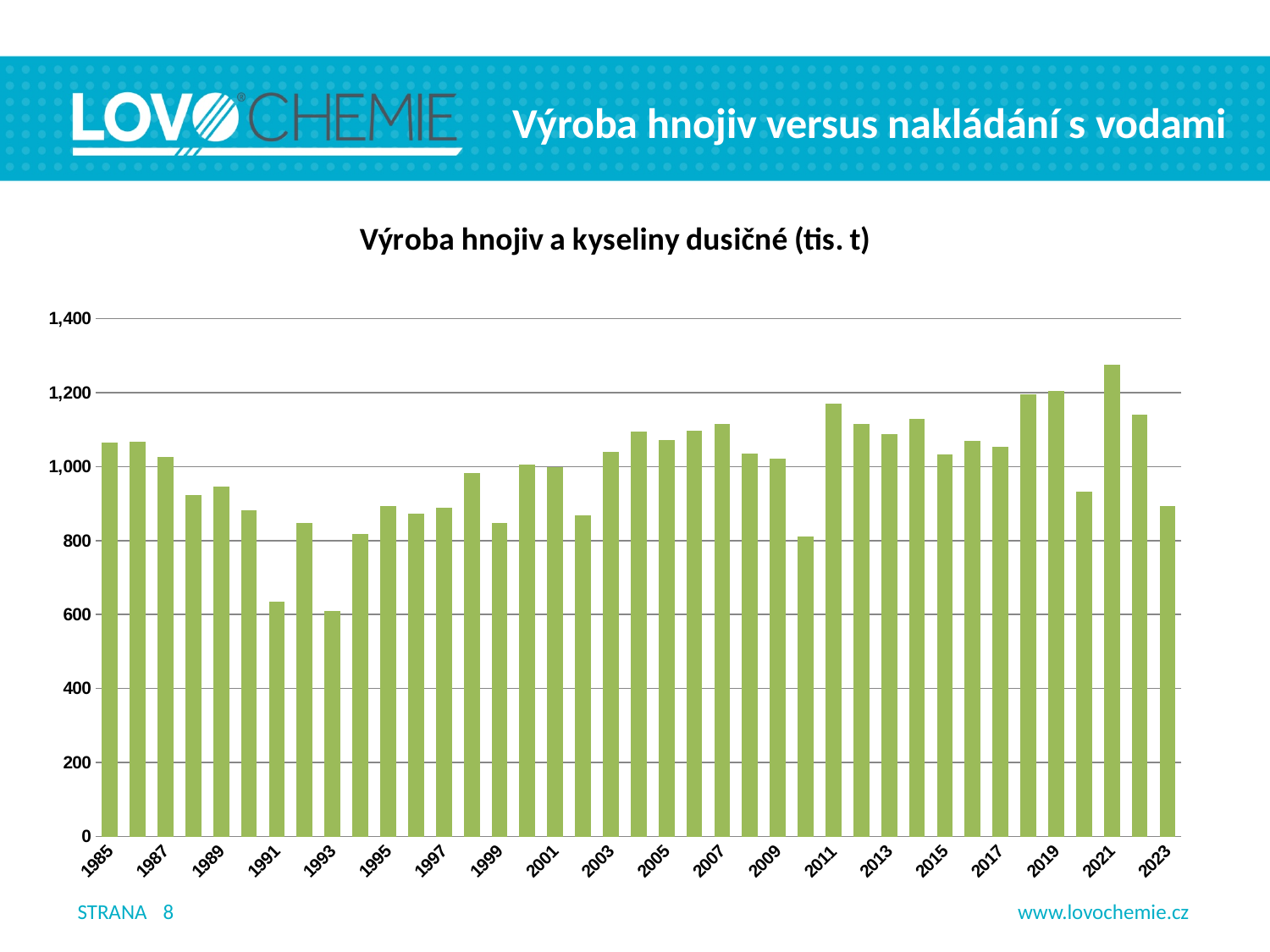
Is the value for 2021 greater or less than 1,200? greater What is the title of the chart? Výroba hnojiv a kyseliny dusičné (tis. t) Is the value for 2011 greater or less than 1,000? greater How many bars (years) are plotted in the chart? 39 Is the value for 1997 greater or less than 1,000? less Do the values rise or fall from 1985 to 1993? fall Which year has the highest bar in the chart? 2021 What kind of chart is shown on the slide? bar chart Which is larger, the value for 1985 or the value for 1991? 1985 Which is larger, the value for 2021 or the value for 2023? 2021